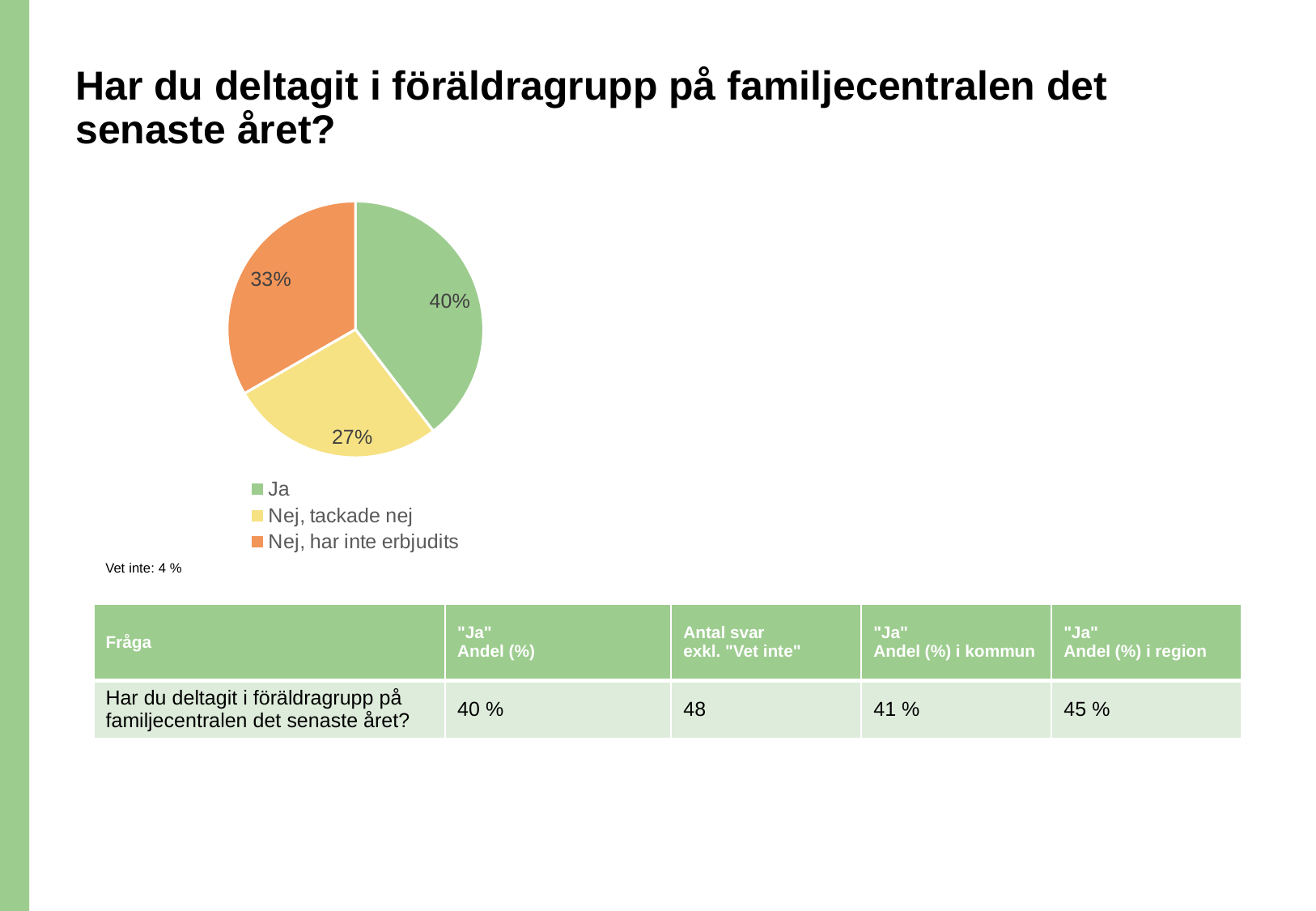
How many slices does the pie chart have? 3 Which is larger, the "Nej, har inte erbjudits" slice or the "Nej, tackade nej" slice? Nej, har inte erbjudits Which slice of the pie is the largest? Ja What kind of chart is shown on the slide? pie chart What colour is the "Nej, har inte erbjudits" slice in the pie chart? orange What share of the pie does "Nej, har inte erbjudits" have? 33% What colour is the "Ja" slice in the pie chart? green What share of the pie does "Ja" have? 40% What share of the pie does "Nej, tackade nej" have? 27% Which slice of the pie is the smallest? Nej, tackade nej How many entries does the legend list? 3 What is the difference in percentage points between the "Ja" slice and the "Nej, tackade nej" slice? 13